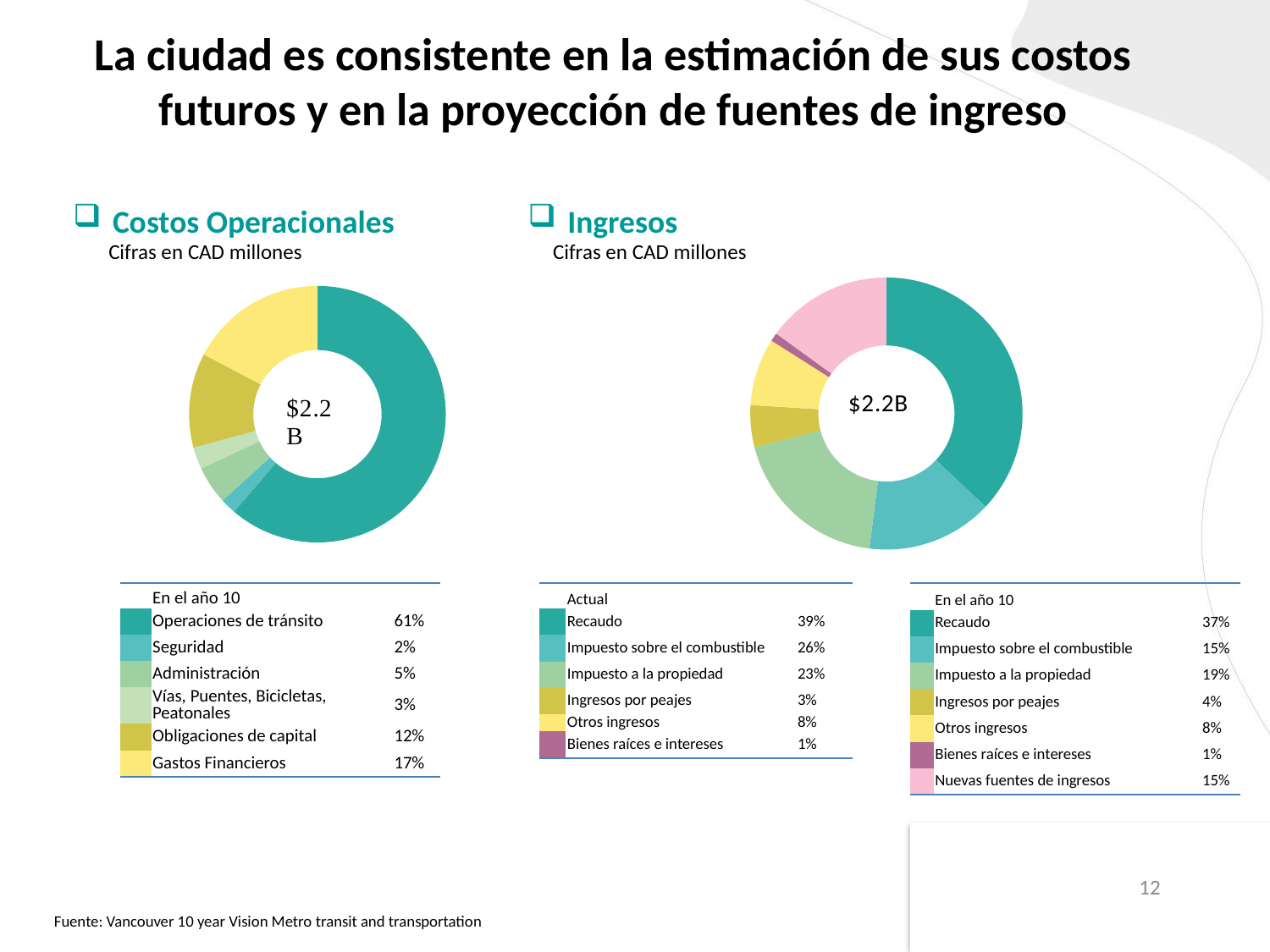
In the Ingresos chart (En el año 10), what share is Nuevas fuentes de ingresos? 15% In the Ingresos chart (En el año 10), which category has the largest share? Recaudo In the Costos Operacionales chart, what is the difference between Obligaciones de capital and Administración? 7% In the Costos Operacionales chart, what share is Operaciones de tránsito? 61% In the Costos Operacionales chart, which category has the largest share? Operaciones de tránsito How many categories does the Ingresos chart legend for En el año 10 list? 7 In the Costos Operacionales chart, which category has the smallest share? Seguridad What total value is shown in the centre of the Ingresos donut chart? $2.2B In the Ingresos chart (En el año 10), which is larger, Impuesto a la propiedad or Impuesto sobre el combustible? Impuesto a la propiedad How many categories does the Costos Operacionales chart legend list? 6 What kind of chart is used for Costos Operacionales? donut chart In the Costos Operacionales chart, what share is Gastos Financieros? 17%